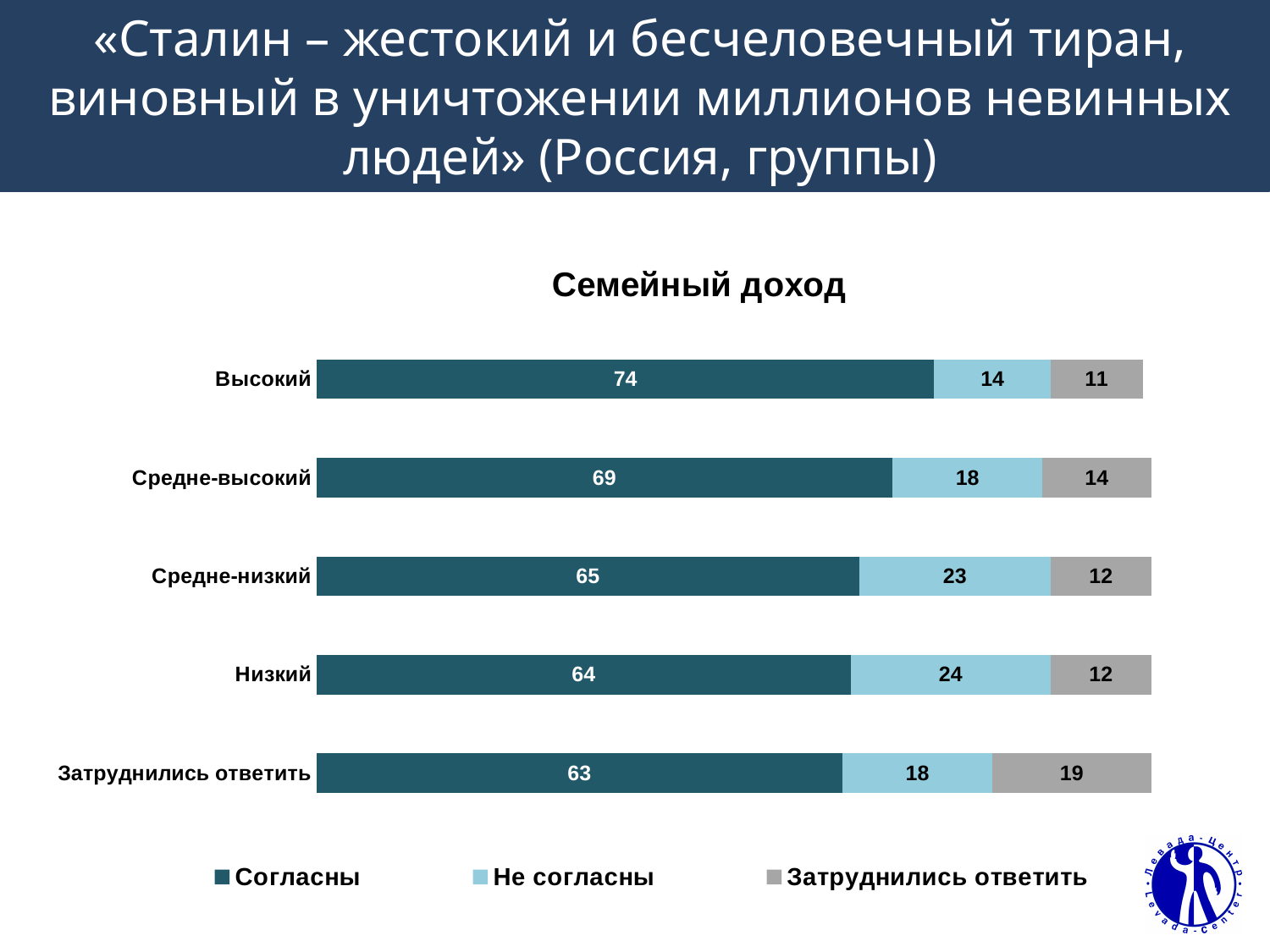
Which category has the lowest value for "Согласны"? Затруднились ответить What is the value for "Затруднились ответить" in the "Затруднились ответить" category? 19 How many series does the legend list? 3 What is the total of the stacked bar for "Средне-высокий"? 101 How many categories are shown on the chart? 5 Which is larger: the "Не согласны" value for "Средне-низкий" or for "Средне-высокий"? Средне-низкий What is the title of the chart? Семейный доход What kind of chart is shown on the slide? Stacked bar chart What is the value for "Не согласны" in the "Низкий" category? 24 What is the value for "Согласны" in the "Высокий" category? 74 Which category has the highest value for "Согласны"? Высокий What is the difference between the "Согласны" values for "Высокий" and "Низкий"? 10